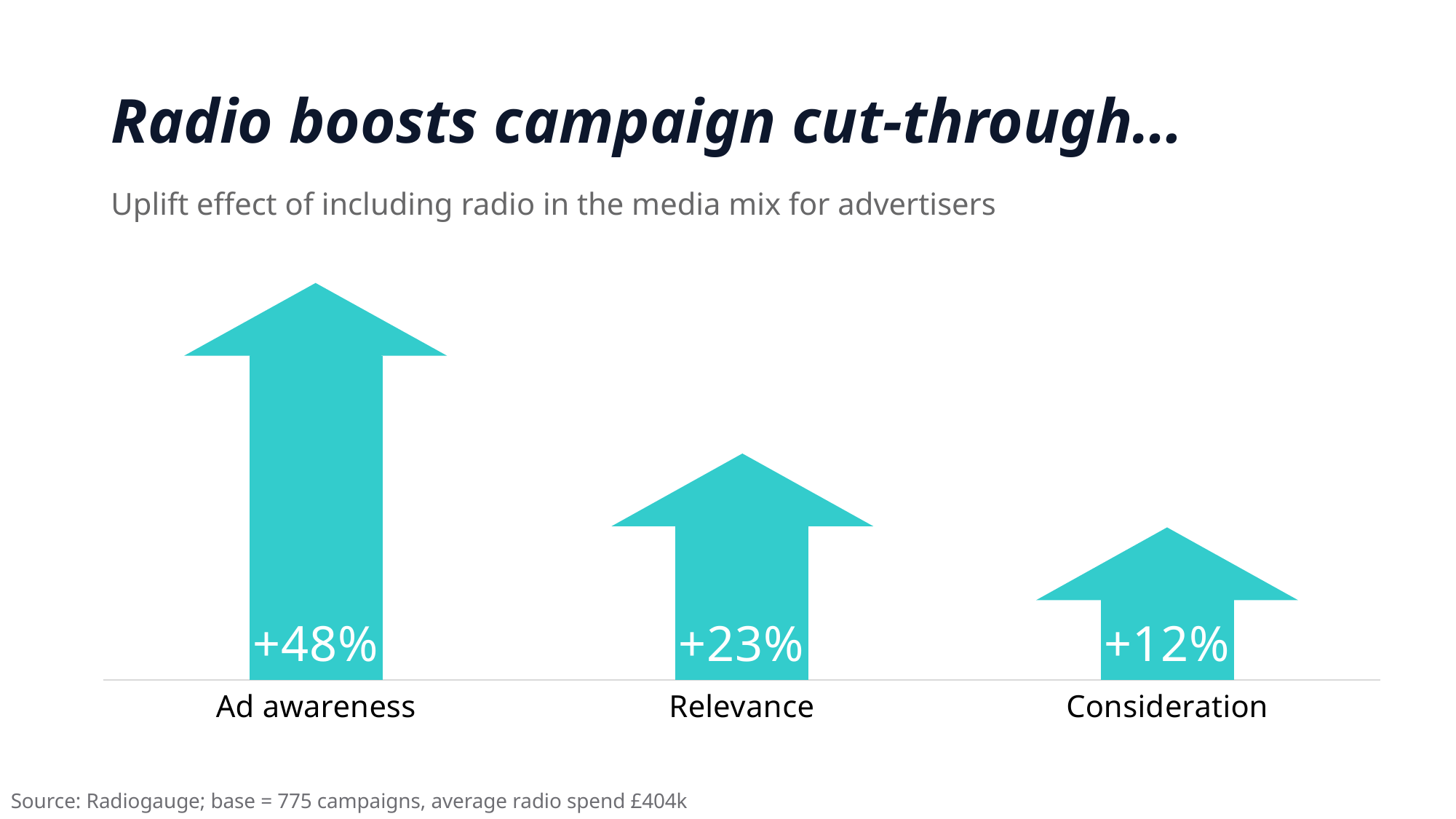
How many categories are shown in the chart? 3 What is the difference in percentage points between the uplift for Ad awareness and Relevance? 25 percentage points Which category shows the highest uplift? Ad awareness What is the uplift value shown for Relevance? +23% Which category shows the lowest uplift? Consideration Which has a larger uplift, Relevance or Consideration? Relevance What is the difference in percentage points between the uplift for Relevance and Consideration? 11 percentage points What is the subtitle describing the chart? Uplift effect of including radio in the media mix for advertisers What kind of chart is shown on the slide? Bar chart (arrow-shaped bars) Do the values rise or fall from left to right across the categories? Fall What is the uplift value shown for Consideration? +12% What is the uplift value shown for Ad awareness? +48%